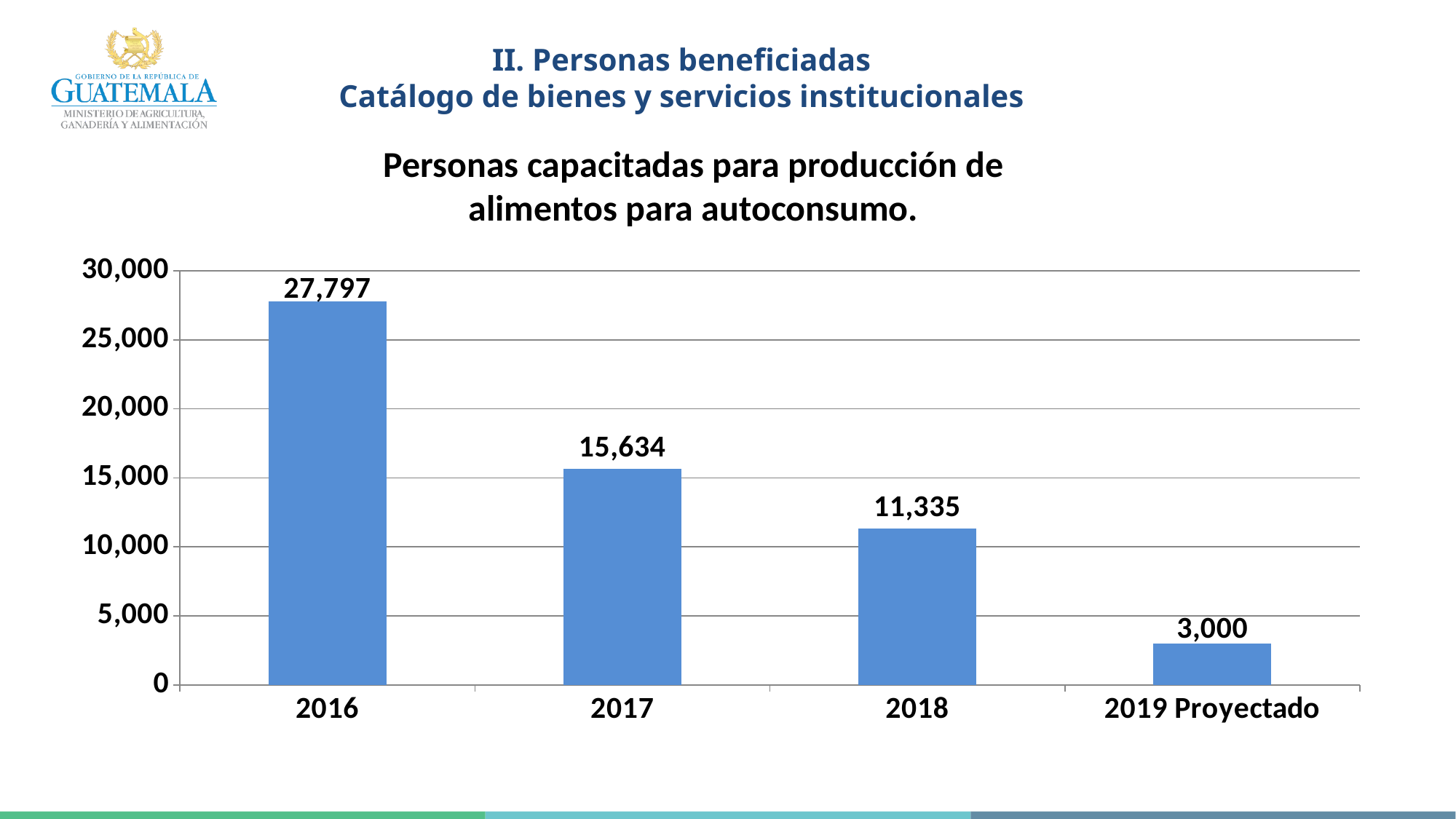
Which category has the lowest value? 2019 Proyectado What is the difference between the values for 2017 and 2018? 4,299 What is the difference between the values for 2016 and 2017? 12,163 Do the values rise or fall from 2016 to 2019 Proyectado? fall What kind of chart is this? bar chart What is the value for 2019 Proyectado? 3,000 What is the value for 2016? 27,797 What is the value for 2017? 15,634 How many categories are shown on the x axis? 4 Which year has the highest value? 2016 What is the value for 2018? 11,335 Which is larger, the value for 2017 or the value for 2018? 2017